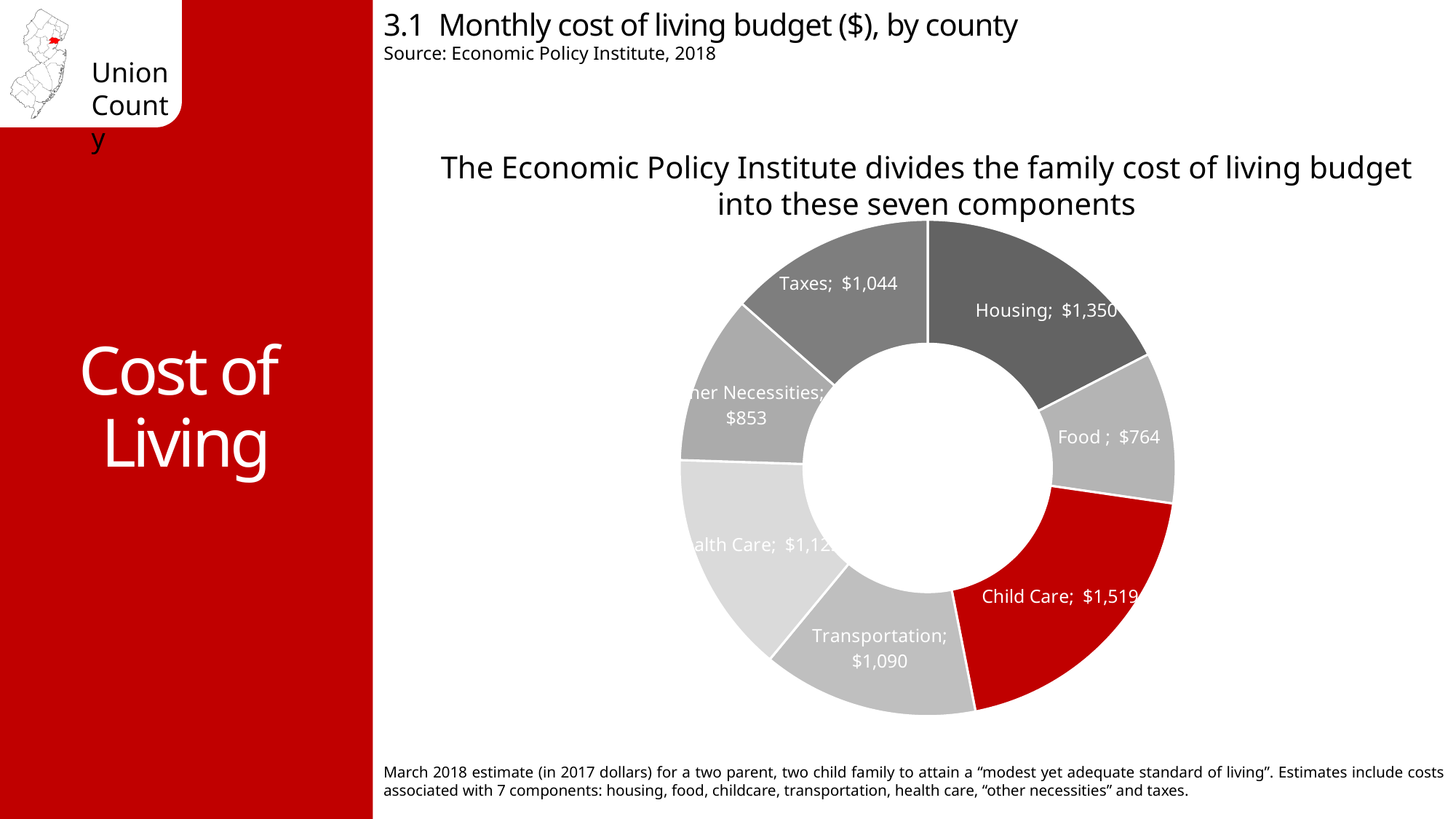
What is the monthly cost for Taxes shown on the chart? $1,044 Which is larger, the cost for Transportation or the cost for Taxes? Transportation Which component has the lowest monthly cost? Food What kind of chart is shown on the slide? Doughnut (pie) chart Which component has the highest monthly cost? Child Care What is the difference between the Child Care cost and the Housing cost? $169 What is the monthly cost for Transportation shown on the chart? $1,090 Which component's slice is coloured red? Child Care What is the monthly cost for Housing shown on the chart? $1,350 What is the monthly cost for Food shown on the chart? $764 What is the monthly cost for Child Care shown on the chart? $1,519 How many components are shown in the chart? 7